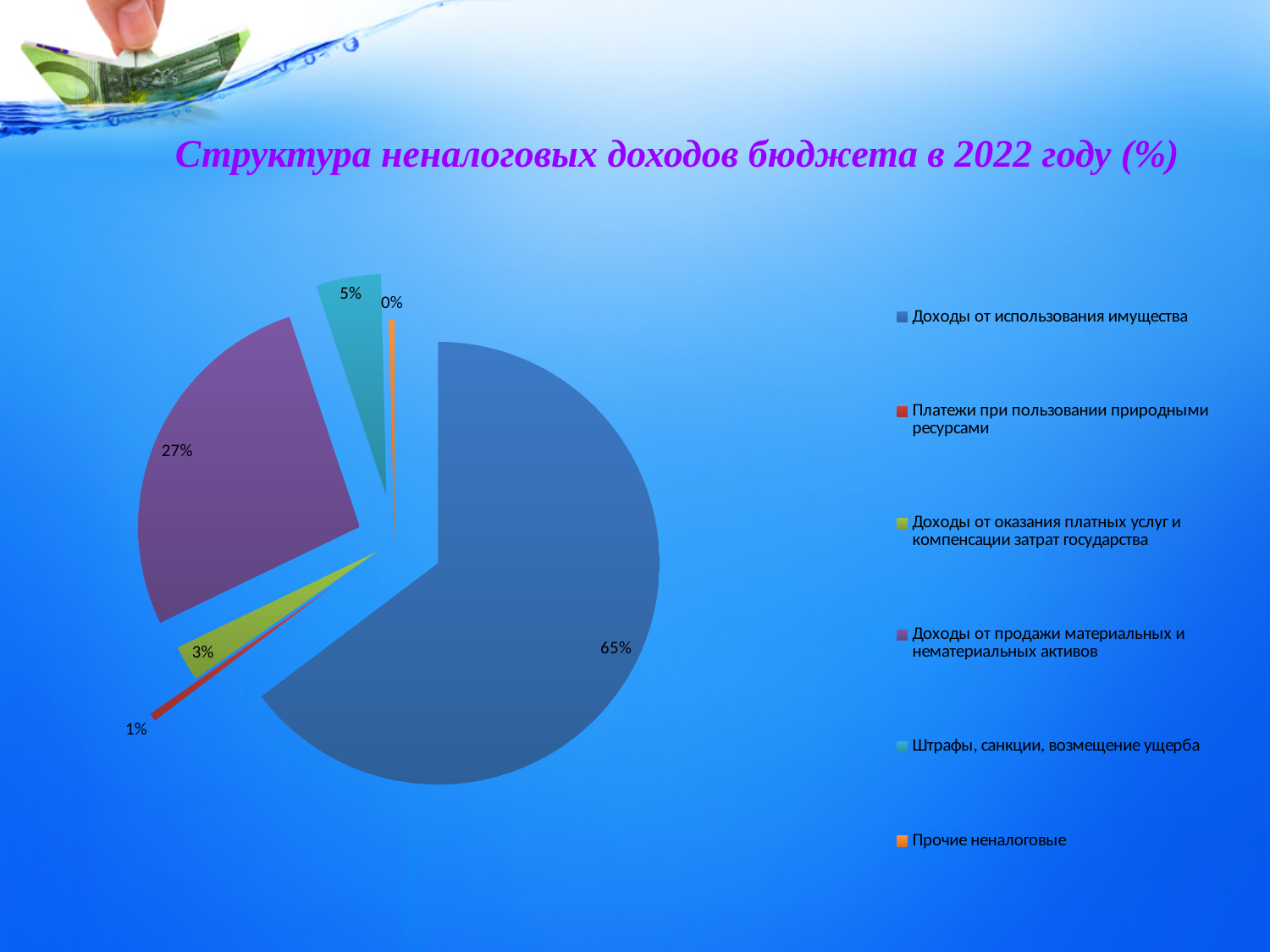
На сколько процентных пунктов доля «Доходов от использования имущества» больше доли «Доходов от продажи материальных и нематериальных активов»? 38 Как называется диаграмма на слайде? Структура неналоговых доходов бюджета в 2022 году (%) Какова доля категории «Прочие неналоговые»? 0% Какова доля категории «Платежи при пользовании природными ресурсами»? 1% Какая категория имеет наименьшую долю в структуре неналоговых доходов? Прочие неналоговые Какая категория имеет наибольшую долю в структуре неналоговых доходов? Доходы от использования имущества Какова доля категории «Доходы от использования имущества»? 65% Какова доля категории «Доходы от оказания платных услуг и компенсации затрат государства»? 3% Какова доля категории «Доходы от продажи материальных и нематериальных активов»? 27% Какой тип диаграммы показан на слайде? Круговая диаграмма Какова доля категории «Штрафы, санкции, возмещение ущерба»? 5% Сколько категорий перечислено в легенде диаграммы? 6